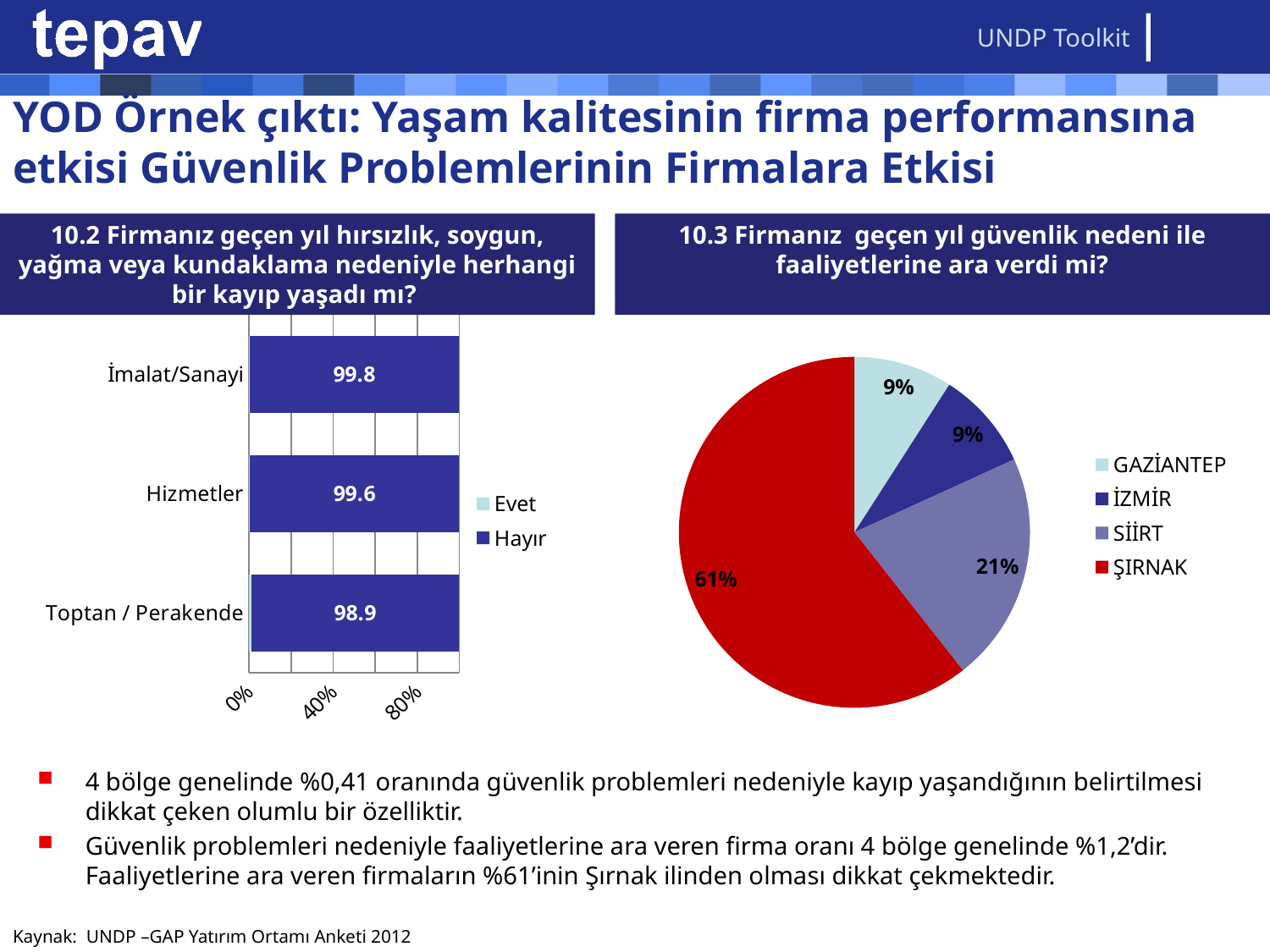
In the pie chart titled "10.3 Firmanız geçen yıl güvenlik nedeni ile faaliyetlerine ara verdi mi?", what share does ŞIRNAK have? 61% In the pie chart on the right, how many slices does the legend list? 4 In the bar chart on the left, which category has the lowest Hayır value? Toptan / Perakende In the chart titled "10.2 Firmanız geçen yıl hırsızlık, soygun, yağma veya kundaklama nedeniyle herhangi bir kayıp yaşadı mı?", what is the Hayır value for Toptan / Perakende? 98.9 In the bar chart on the left, which category has the highest Hayır value? İmalat/Sanayi In the pie chart on the right, what share does SİİRT have? 21% In the bar chart on the left, how many categories are shown on the vertical axis? 3 In the pie chart on the right, which slice is the largest? ŞIRNAK In the bar chart on the left, how many series does the legend list? 2 What kind of chart is the chart on the left of the slide? Bar chart In the chart titled "10.2 Firmanız geçen yıl hırsızlık, soygun, yağma veya kundaklama nedeniyle herhangi bir kayıp yaşadı mı?", what is the Hayır value for İmalat/Sanayi? 99.8 In the bar chart on the left, what is the difference between the Hayır values for İmalat/Sanayi and Toptan / Perakende? 0.9